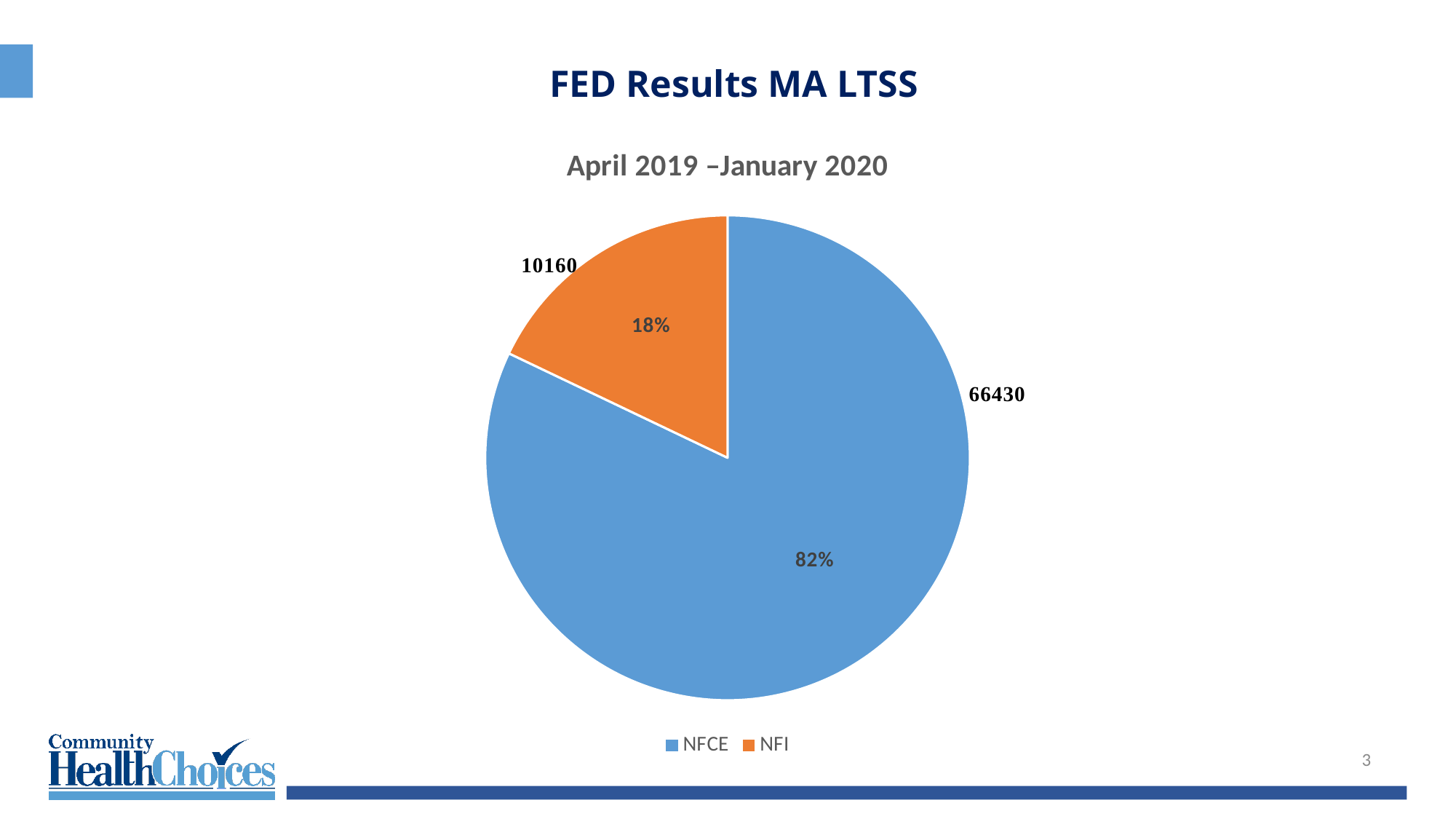
How many slices does the pie chart have? 2 Which category has the smallest slice? NFI What share of the pie does NFI represent? 18% What kind of chart is shown on the slide? pie chart Which category has the largest slice? NFCE What colour is the NFI slice? orange What is the value for NFCE? 66430 What is the difference between the NFCE and NFI values? 56270 Which is larger, NFCE or NFI? NFCE What is the value for NFI? 10160 What is the title of the chart? April 2019 –January 2020 What share of the pie does NFCE represent? 82%